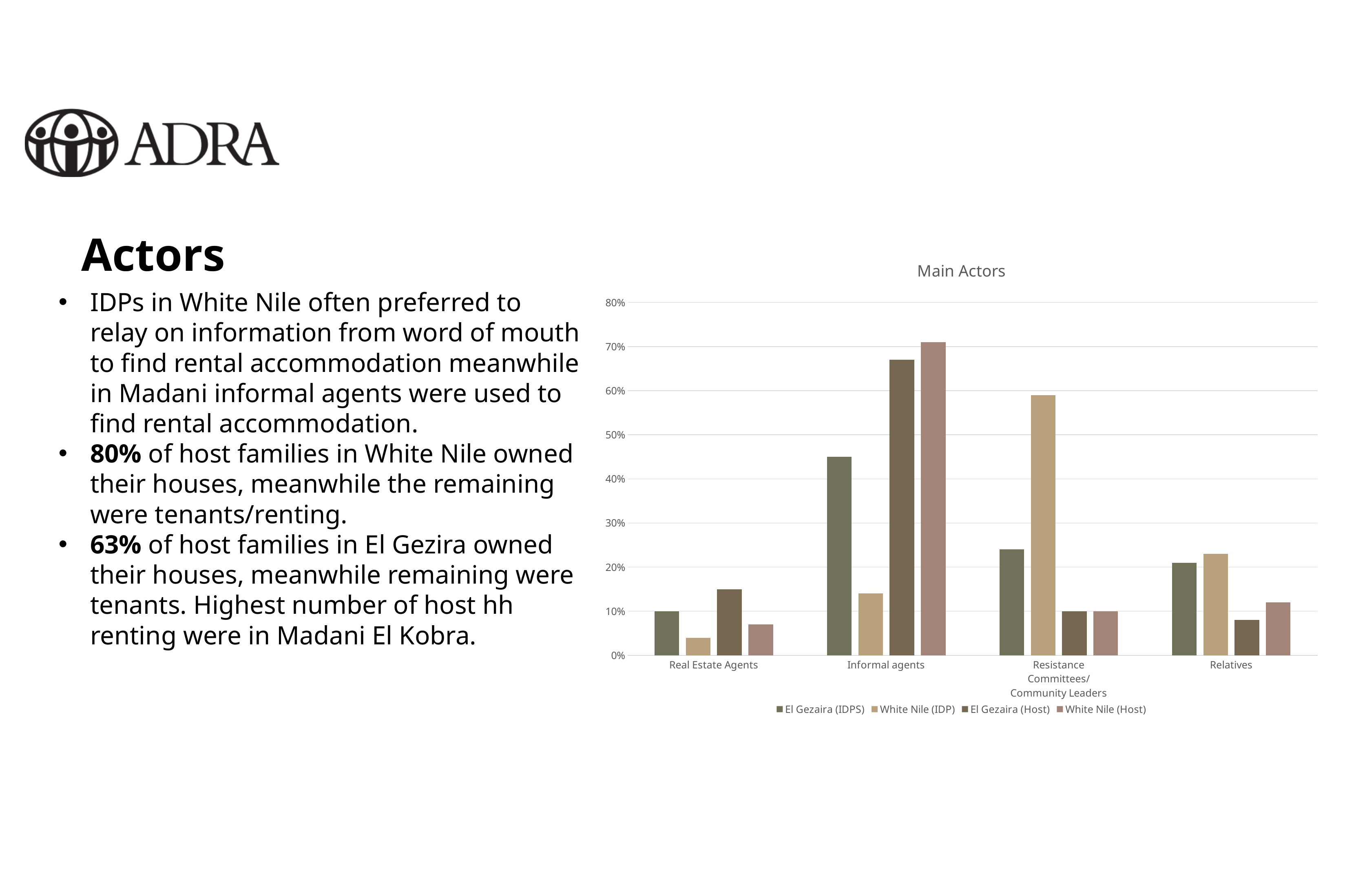
What is the title of the chart on the slide? Main Actors How many series does the legend of the Main Actors chart list? 4 What kind of chart is shown on the slide? bar chart In the Main Actors chart, for Informal agents, which is larger: El Gezaira (IDPS) or White Nile (IDP)? El Gezaira (IDPS) In the Main Actors chart, is the value for White Nile (IDP) under Resistance Committees/Community Leaders greater or less than 50%? greater In the Main Actors chart, which series has the highest value for Informal agents? White Nile (Host) In the Main Actors chart, is the value for White Nile (IDP) under Real Estate Agents greater or less than 10%? less In the Main Actors chart, which series has the lowest value for Relatives? El Gezaira (Host) How many categories are shown on the x axis of the Main Actors chart? 4 In the Main Actors chart, is the value for El Gezaira (Host) under Informal agents greater or less than 60%? greater In the Main Actors chart, which series has the highest value for Resistance Committees/Community Leaders? White Nile (IDP) In the Main Actors chart, which series has the lowest value for Real Estate Agents? White Nile (IDP)